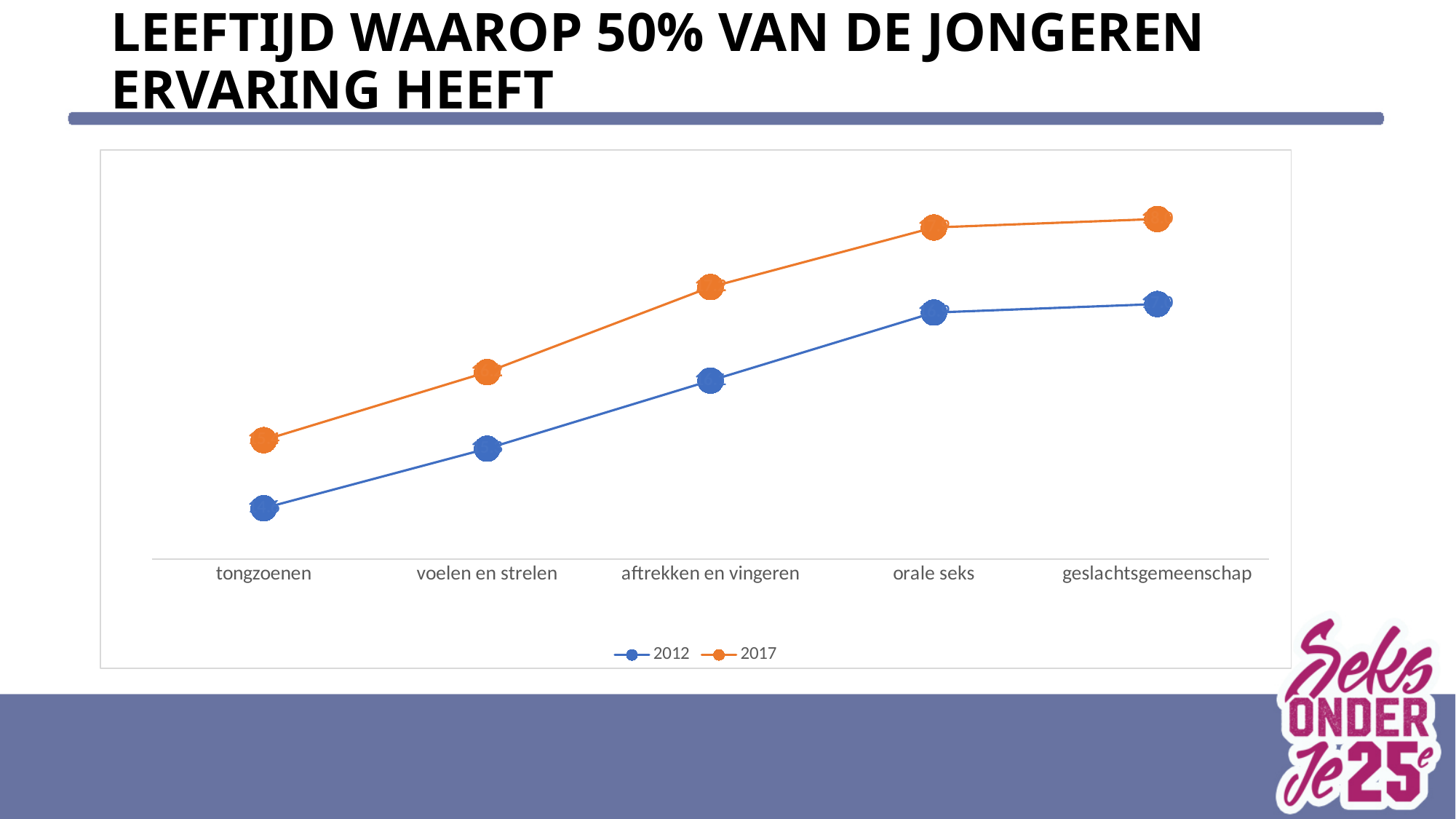
For the 2012 series, which category has the lowest value? tongzoenen For 'tongzoenen', which series has the larger value, 2012 or 2017? 2017 What kind of chart is shown on the slide? line chart How many series does the legend list? 2 Which colour is used for the 2017 series? orange How many categories are shown along the x axis? 5 Do the values of the 2012 series rise or fall from 'tongzoenen' to 'geslachtsgemeenschap'? rise For the 2017 series, which category has the lowest value? tongzoenen For 'orale seks', which series has the larger value, 2012 or 2017? 2017 Which series are listed in the legend? 2012 and 2017 For the 2017 series, which category has the highest value? geslachtsgemeenschap Do the values of the 2017 series rise or fall along the x axis? rise